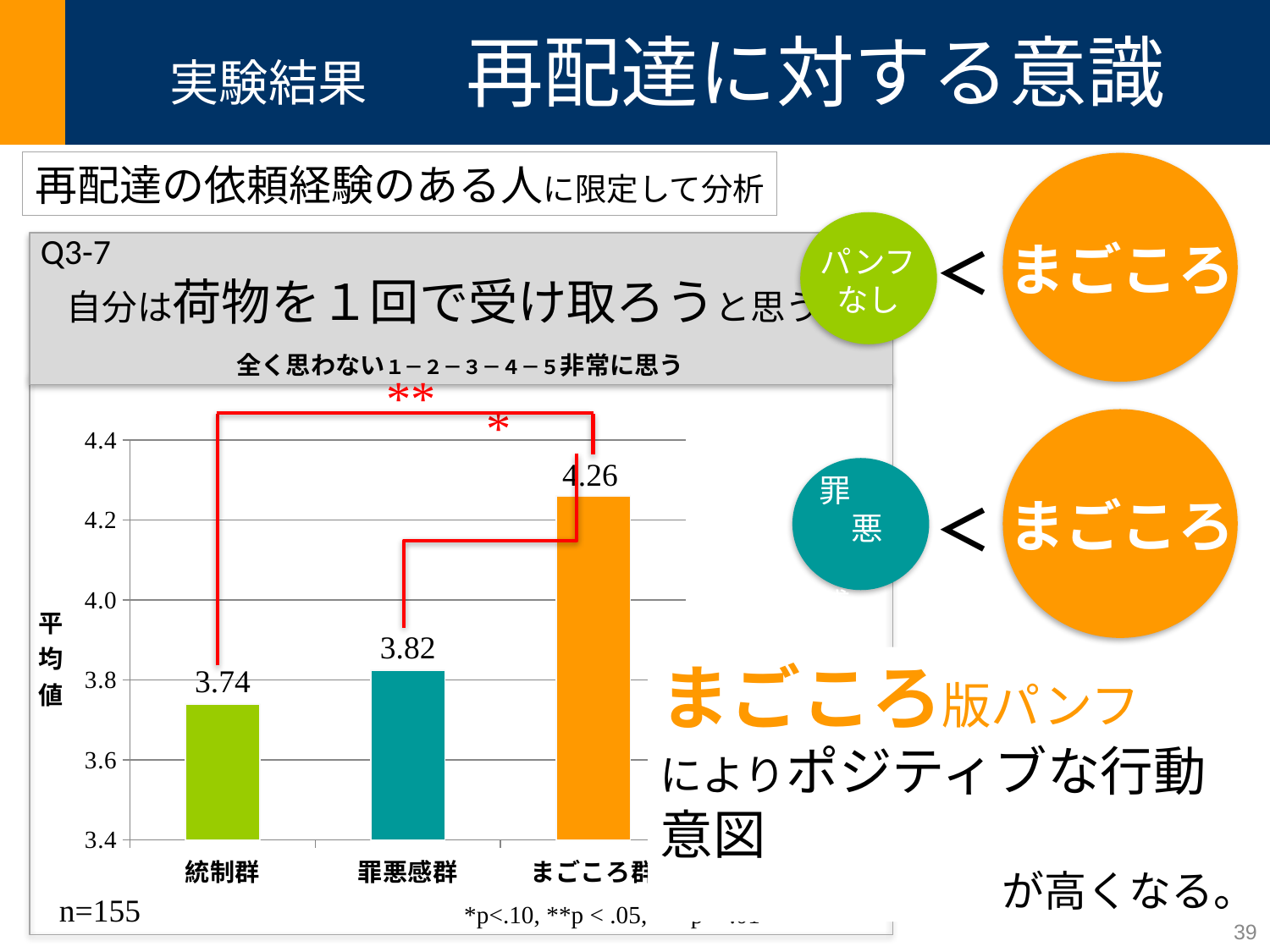
Which group has the lowest mean value? 統制群 Which has a larger mean value, 統制群 or まごころ群? まごころ群 What is the difference between the mean values of まごころ群 and 罪悪感群? 0.44 What kind of chart is shown on the slide? bar chart Which group has the highest mean value? まごころ群 How many groups are shown on the x axis of the chart? 3 What is the mean value for 罪悪感群? 3.82 What is the mean value for まごころ群? 4.26 What is the sample size (n) noted on the chart? n=155 Is the value for まごころ群 greater or less than 4.0? greater What is the difference between the mean values of まごころ群 and 統制群? 0.52 What is the mean value for 統制群? 3.74